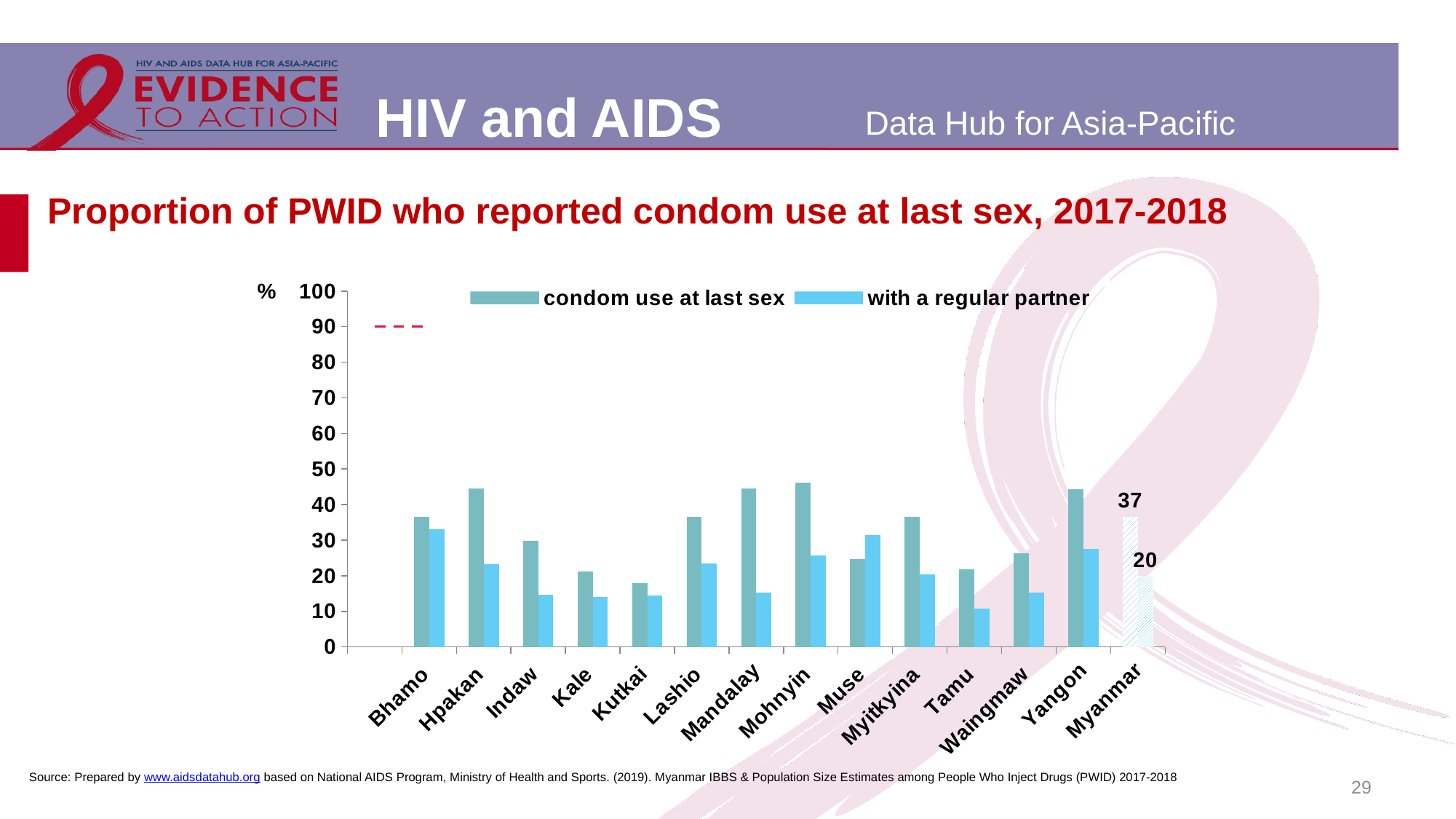
Is the 'condom use at last sex' value for Mohnyin greater or less than 40? greater Which site has the lowest value for 'with a regular partner'? Tamu What kind of chart is shown on the slide? bar chart How many categories are shown on the x axis? 14 What is the value for Myanmar in the 'condom use at last sex' series? 37 Is the 'condom use at last sex' value for Bhamo greater or less than 30? greater What is the value for Myanmar in the 'with a regular partner' series? 20 Is the 'with a regular partner' value for Tamu greater or less than 20? less How many series does the legend list? 2 Which has a higher 'condom use at last sex' value, Hpakan or Indaw? Hpakan For Myanmar, what is the difference between 'condom use at last sex' and 'with a regular partner'? 17